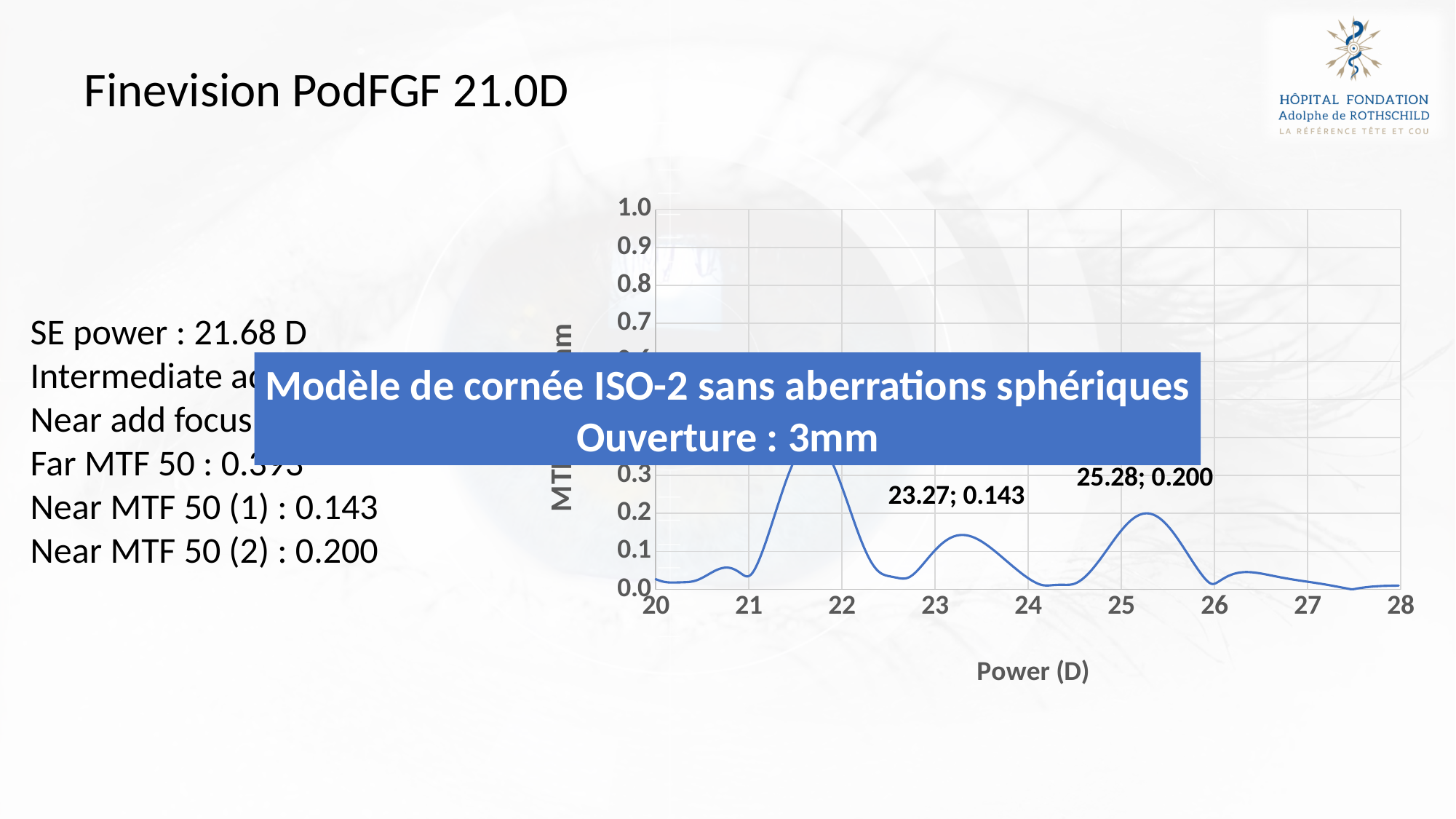
What is the label of the x axis of the chart? Power (D) Does the MTF curve rise or fall between 25.28 D and 26 D? fall What is the difference between the labelled MTF values at 25.28 D and 23.27 D? 0.057 What is the MTF value labelled at a power of 25.28 D? 0.200 What is the highest value shown on the y axis of the chart? 1.0 Is the MTF value at a power of 26 D greater or less than 0.1? less What is the MTF value labelled at a power of 23.27 D? 0.143 Which labelled point has the higher MTF value, 23.27 D or 25.28 D? 25.28 D How many data points on the chart carry a printed value label? 2 Is the MTF value at a power of 24 D greater or less than 0.1? less Is the MTF value at a power of 27 D greater or less than 0.1? less What kind of chart is shown on the slide? line chart